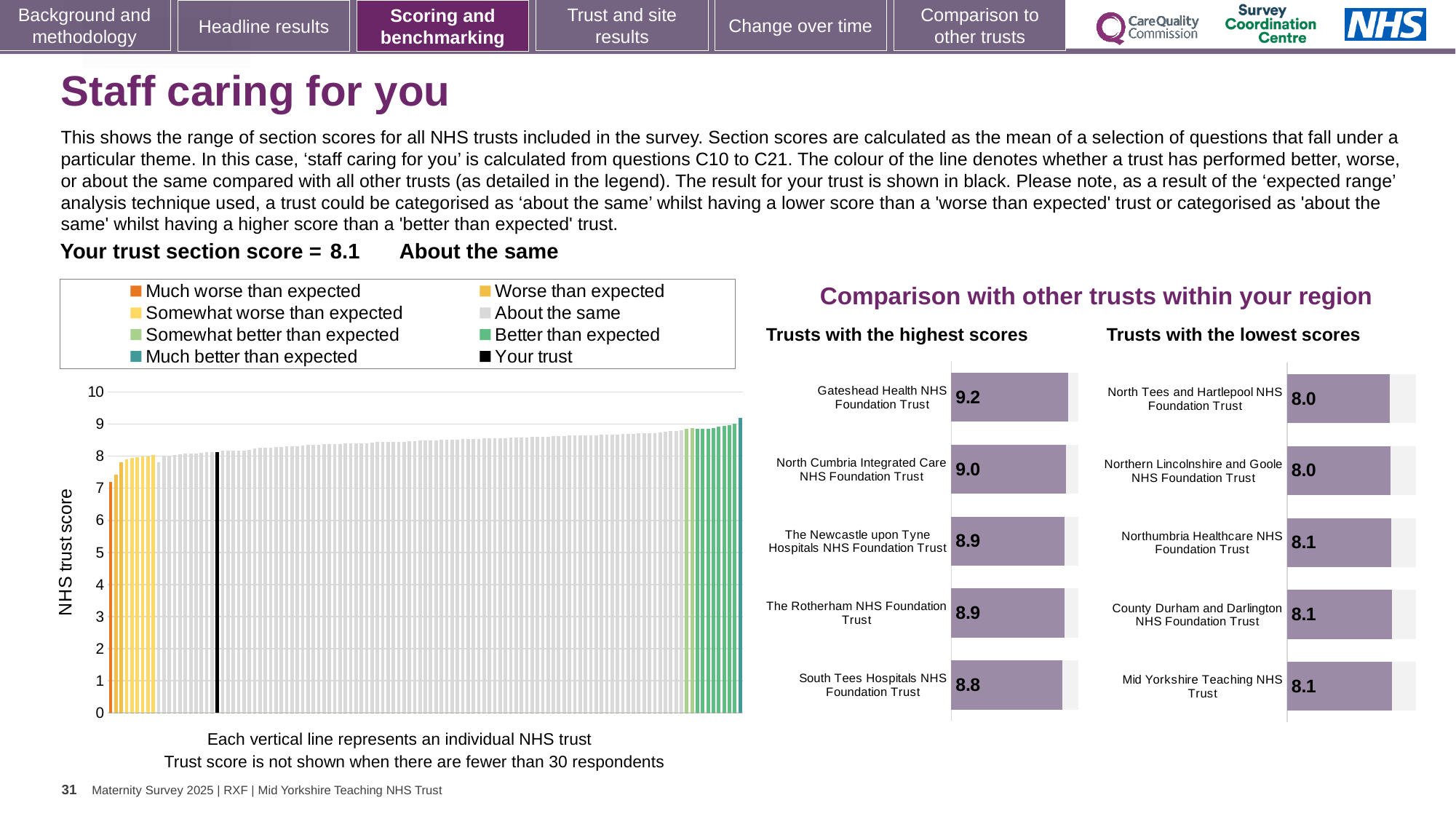
In the 'Trusts with the highest scores' chart, which has the larger score: North Cumbria Integrated Care NHS Foundation Trust or The Rotherham NHS Foundation Trust? North Cumbria Integrated Care NHS Foundation Trust In the 'Trusts with the highest scores' chart, what is the difference between the scores of Gateshead Health NHS Foundation Trust and South Tees Hospitals NHS Foundation Trust? 0.4 How many entries does the legend of the large chart on the left list? 8 What is the label on the vertical axis of the large chart on the left? NHS trust score In the 'Trusts with the lowest scores' chart, what is the score for Mid Yorkshire Teaching NHS Trust? 8.1 In the 'Trusts with the highest scores' chart, what is the score for Gateshead Health NHS Foundation Trust? 9.2 What kind of chart is the large chart on the left showing NHS trust scores? Bar chart In the 'Trusts with the highest scores' chart, which trust has the highest score? Gateshead Health NHS Foundation Trust In the 'Trusts with the lowest scores' chart, what is the score for North Tees and Hartlepool NHS Foundation Trust? 8.0 In the large chart on the left, do the trust scores rise or fall from left to right? Rise In the 'Trusts with the highest scores' chart, what is the score for South Tees Hospitals NHS Foundation Trust? 8.8 How many trusts are shown in the 'Trusts with the lowest scores' chart? 5